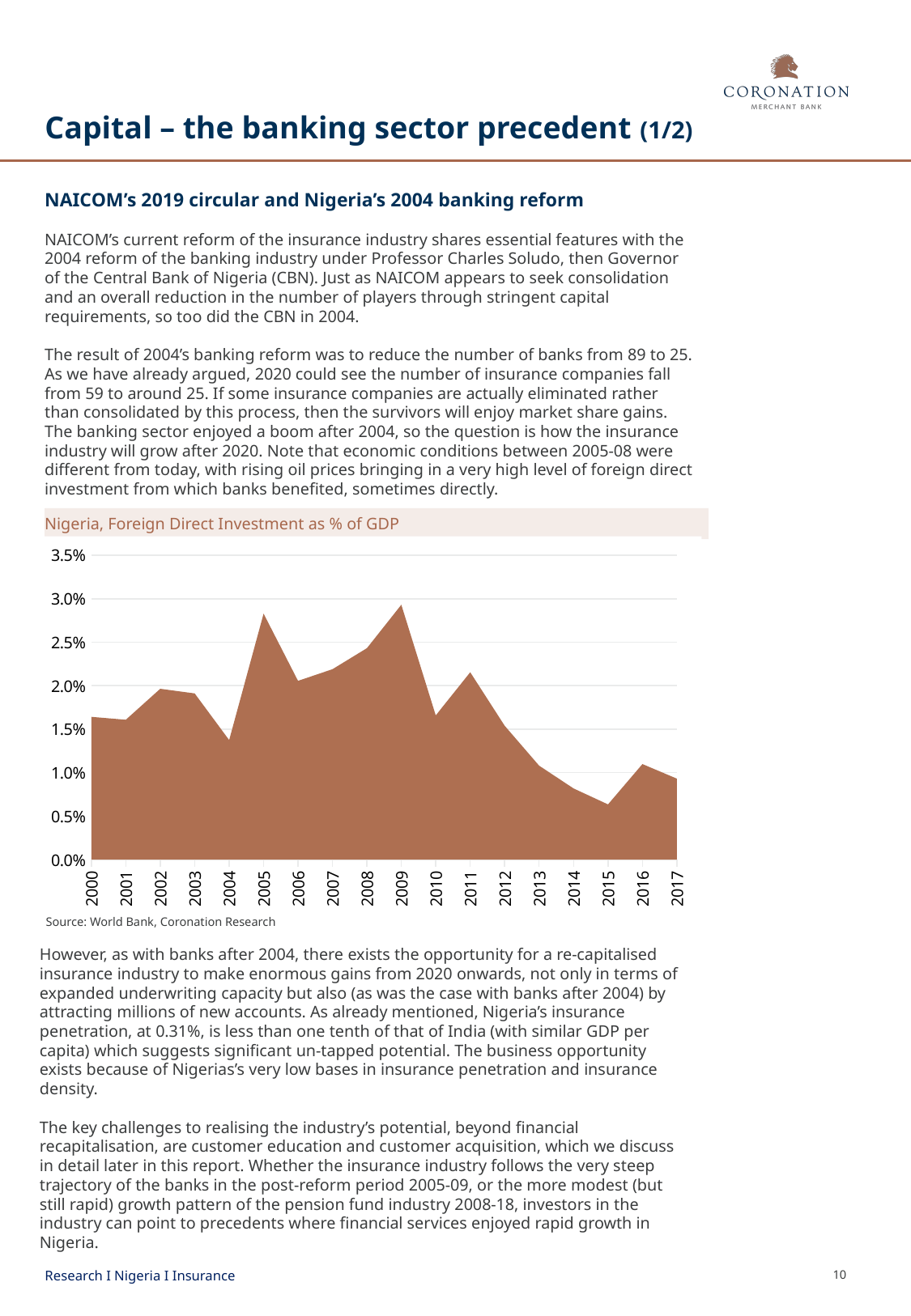
Is the value for 2004 greater or less than 1.5%? less In which year is Nigeria's foreign direct investment as % of GDP lowest? 2015 What is the title of the chart? Nigeria, Foreign Direct Investment as % of GDP How many years are plotted on the x axis of the chart? 18 Is the value for 2005 greater or less than 2.5%? greater What is the source cited below the chart? World Bank, Coronation Research What kind of chart is shown on the slide? Area chart Which year has the larger value, 2009 or 2010? 2009 In which year is Nigeria's foreign direct investment as % of GDP highest? 2009 Is the value for 2008 greater or less than 2.0%? greater Do the values rise or fall from 2012 to 2015? Fall